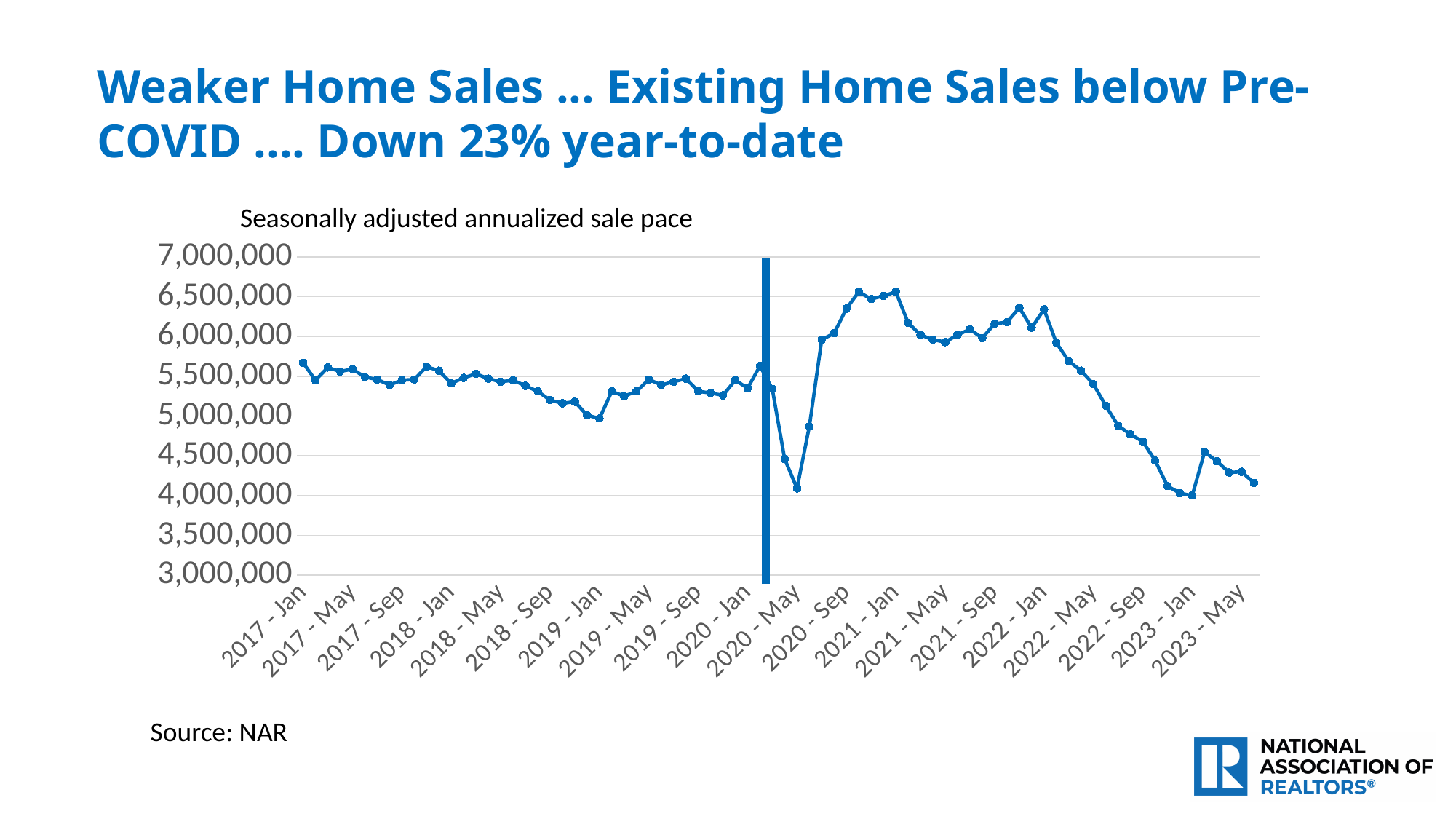
How many labels are shown on the x axis? 20 Is the value for 2022 - Sep greater or less than 5,000,000? less Is the value for 2017 - Jan greater or less than 5,500,000? greater Is the value for 2023 - May greater or less than 4,500,000? less Do the values rise or fall between 2020 - May and 2020 - Sep? rise Which is larger, the value for 2017 - Jan or the value for 2023 - May? 2017 - Jan What is the subtitle printed above the chart? Seasonally adjusted annualized sale pace Which is larger, the value for 2021 - Jan or the value for 2023 - Jan? 2021 - Jan Do the values rise or fall between 2022 - Jan and 2023 - Jan? fall What kind of chart is shown on the slide? line chart